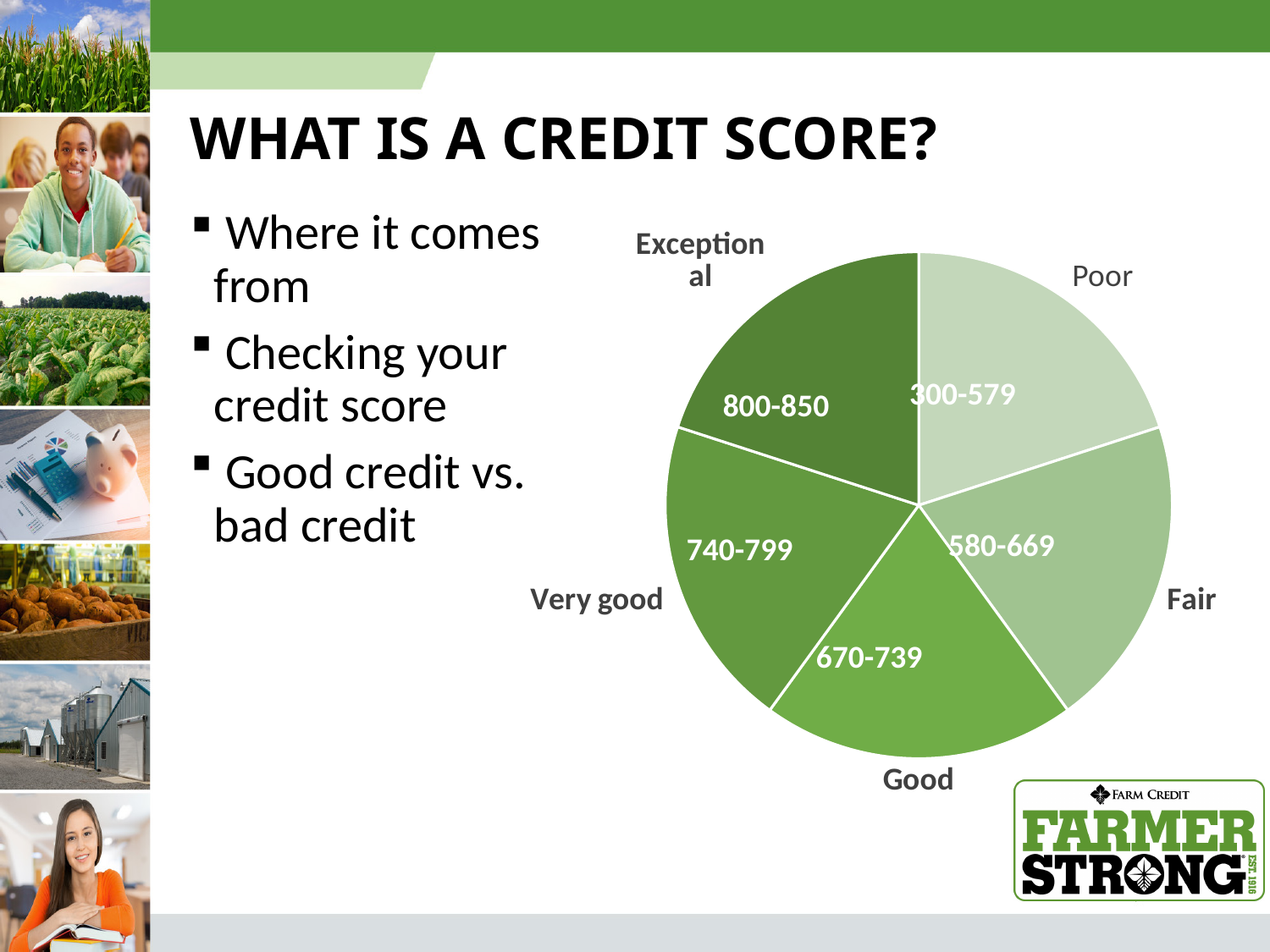
What score range is labelled on the Exceptional slice of the pie chart? 800-850 Which slice of the pie chart carries the label 800-850? Exceptional What score range is labelled on the Poor slice of the pie chart? 300-579 Which slice of the pie chart is the darkest shade of green? Exceptional What kind of chart is shown on the slide? Pie chart What score range is labelled on the Very good slice of the pie chart? 740-799 What score range is labelled on the Good slice of the pie chart? 670-739 How many slices does the pie chart have? 5 Which slice of the pie chart is the lightest shade of green? Poor Which slice of the pie chart carries the label 580-669? Fair What score range is labelled on the Fair slice of the pie chart? 580-669